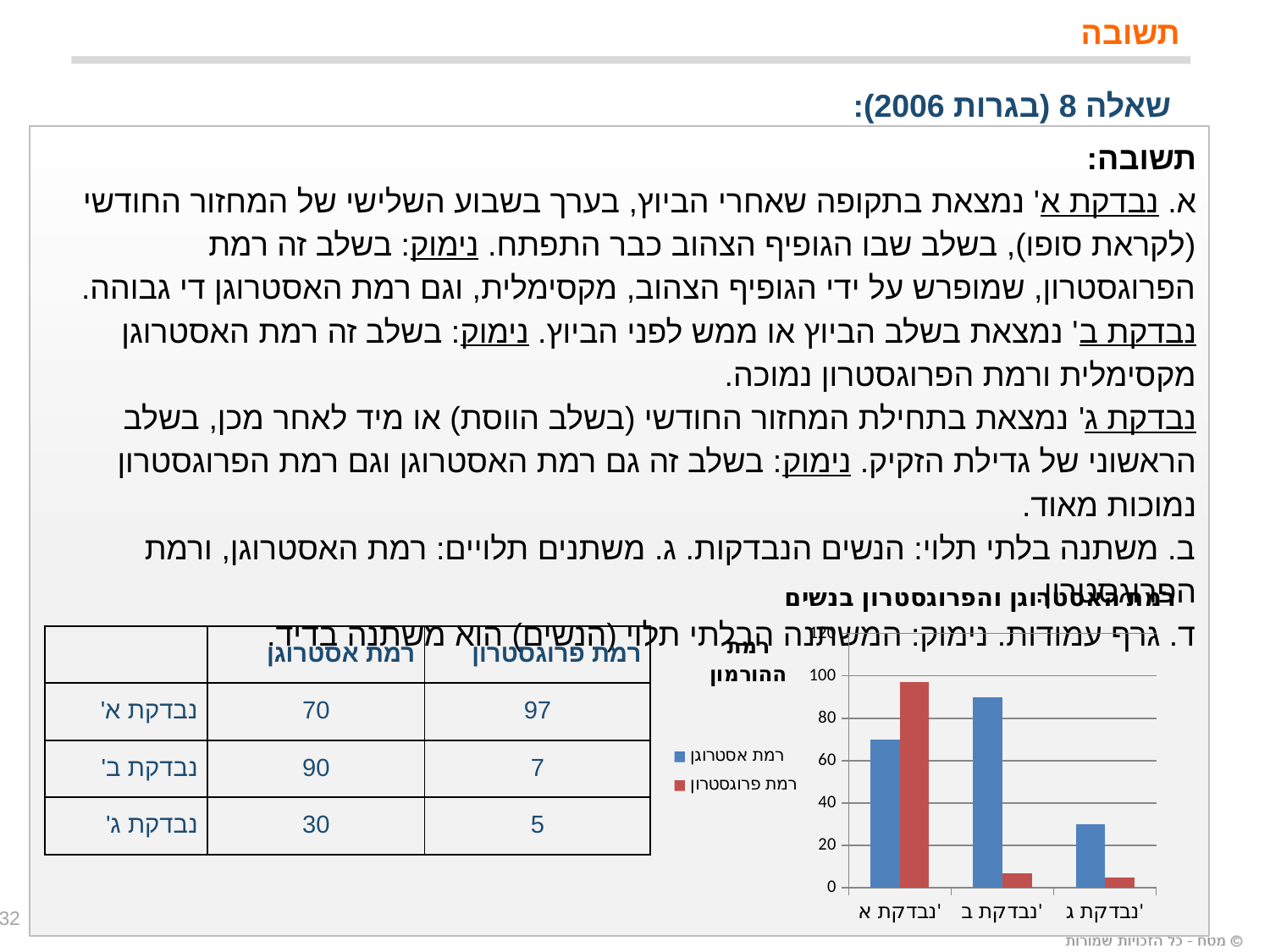
Which subject has the lowest רמת אסטרוגן (estrogen level) in the chart? נבדקת ג' Is the רמת אסטרוגן value for נבדקת ב' greater or less than 80? greater How many series does the chart's legend list? 2 Which subject has the highest רמת אסטרוגן (estrogen level) in the chart? נבדקת ב' What is the difference between the רמת אסטרוגן values of נבדקת ב' and נבדקת ג'? 60 How many categories (subjects) are shown on the x axis of the chart? 3 For נבדקת א', which is larger: רמת אסטרוגן or רמת פרוגסטרון? רמת פרוגסטרון Is the רמת פרוגסטרון value for נבדקת ג' greater or less than 20? less Which subject has the highest רמת פרוגסטרון (progesterone level) in the chart? נבדקת א' What colour represents רמת פרוגסטרון in the chart's legend? red What is the רמת אסטרוגן value for נבדקת א'? 70 What kind of chart is shown on the slide? bar chart